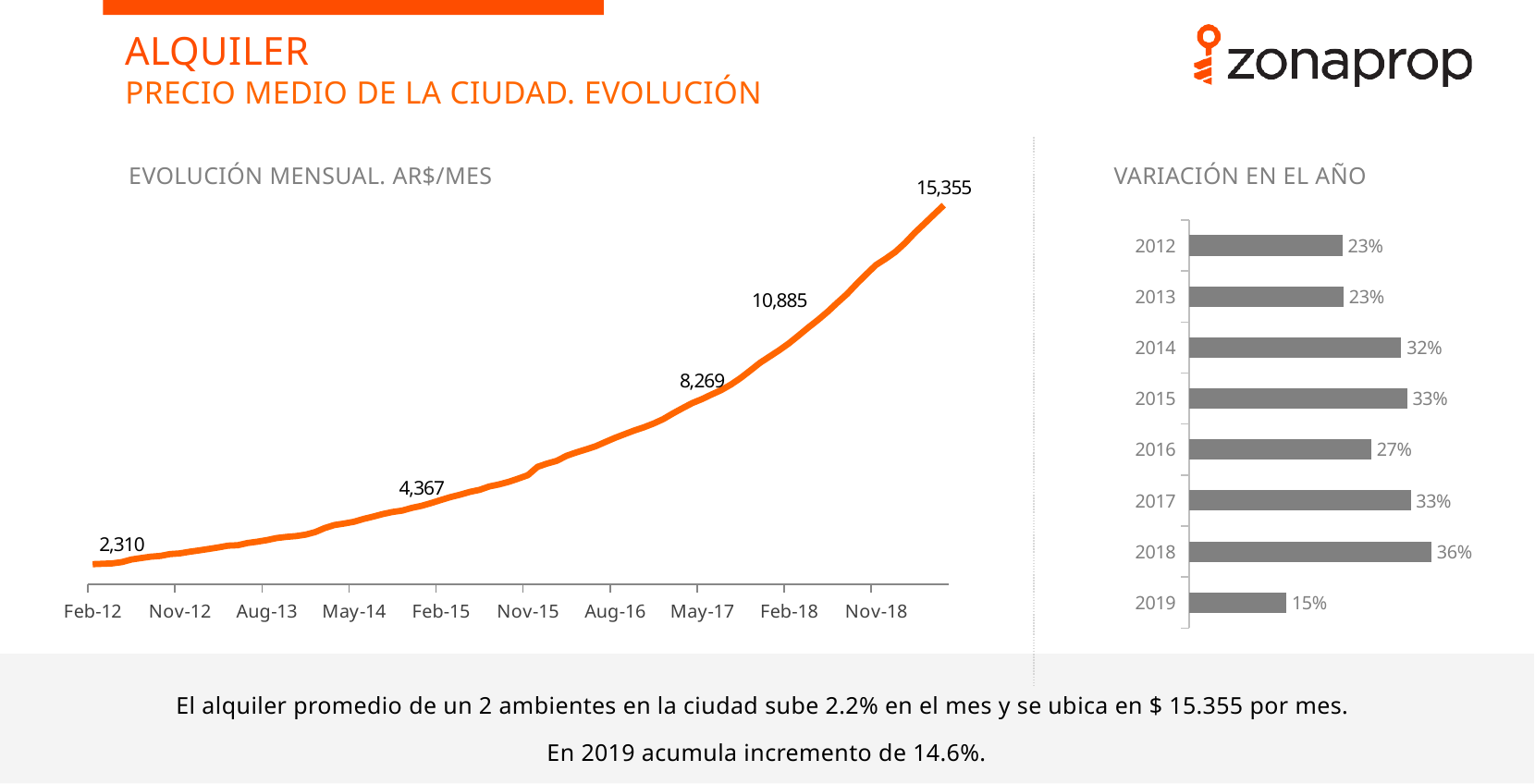
In the 'VARIACIÓN EN EL AÑO' chart, which year has the lowest value? 2019 How many years are shown in the 'VARIACIÓN EN EL AÑO' chart? 8 In the 'VARIACIÓN EN EL AÑO' chart, what is the value for 2019? 15% In the 'VARIACIÓN EN EL AÑO' chart, which is larger, the value for 2014 or the value for 2016? 2014 In the 'VARIACIÓN EN EL AÑO' chart, what is the value for 2018? 36% In the 'EVOLUCIÓN MENSUAL. AR$/MES' chart, what is the last labelled value on the line? 15,355 What kind of chart is the 'EVOLUCIÓN MENSUAL. AR$/MES' chart? Line chart In the 'VARIACIÓN EN EL AÑO' chart, which year has the highest value? 2018 What kind of chart is the 'VARIACIÓN EN EL AÑO' chart? Bar chart In the 'EVOLUCIÓN MENSUAL. AR$/MES' chart, what is the difference between the last labelled value (15,355) and the first labelled value (2,310)? 13,045 In the 'EVOLUCIÓN MENSUAL. AR$/MES' chart, do the values rise or fall over time? Rise In the 'VARIACIÓN EN EL AÑO' chart, what is the difference between the values for 2018 and 2019? 21 percentage points